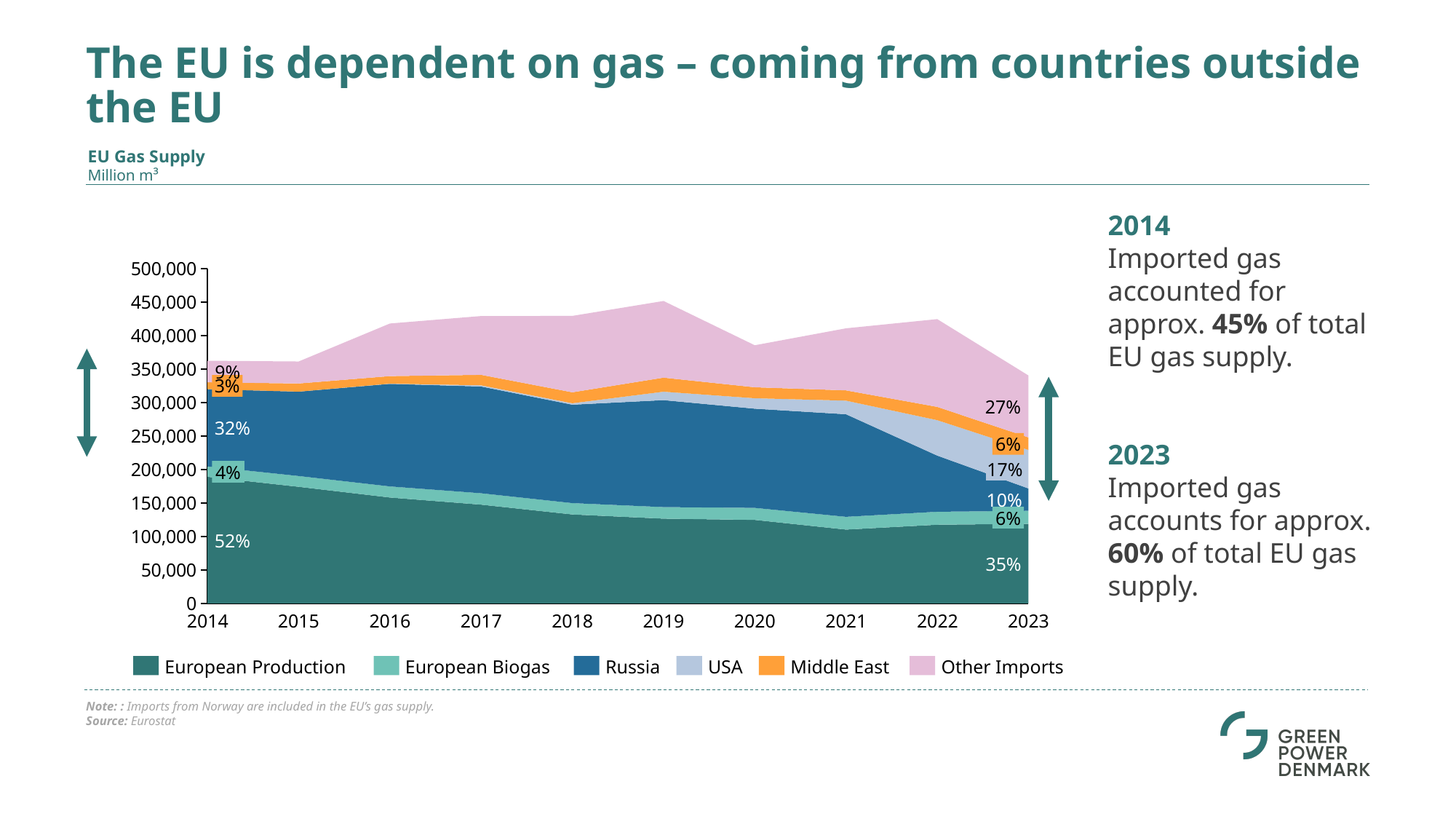
What share of EU gas supply did Russia account for in 2014? 32% Which labelled series had the smallest share of EU gas supply in 2014? Middle East What share of EU gas supply did Russia account for in 2023? 10% What kind of chart is shown on the slide? Stacked area chart By how many percentage points did Russia's share of EU gas supply fall between 2014 and 2023? 22 percentage points What share of EU gas supply did European Production account for in 2014? 52% How many series does the legend list? 6 How many years are shown on the x axis? 10 Was the total EU gas supply in 2019 greater or less than 400,000 million m³? greater What share of EU gas supply did the USA account for in 2023? 17% Does European Production rise or fall from 2014 to 2023? Fall Which labelled series had the largest share of EU gas supply in 2023? European Production